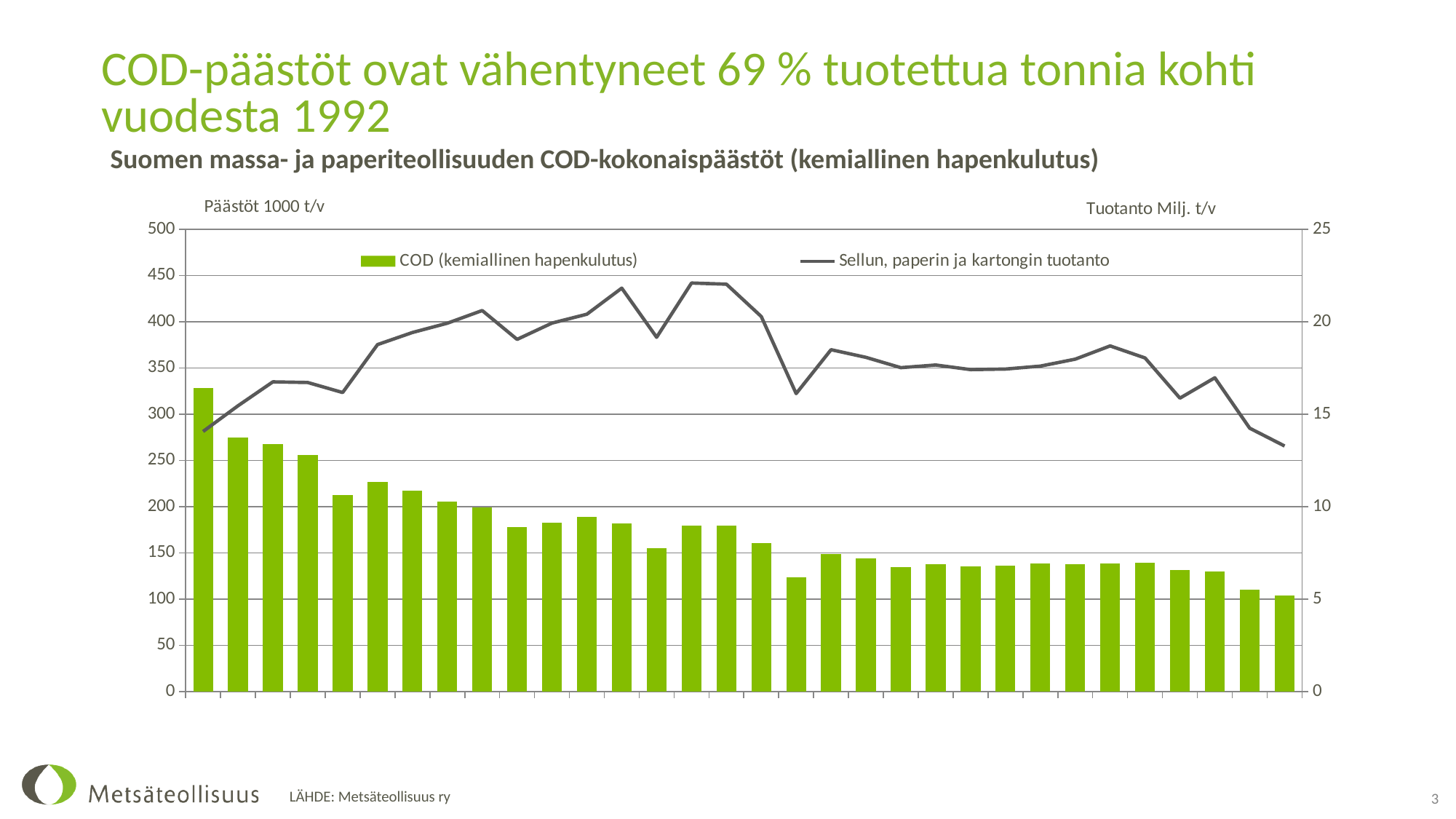
What kind of chart is shown on the slide? A combined bar and line chart Where is the lowest COD bar located in the chart? At the far right What is the maximum value shown on the right vertical axis? 25 Which series is drawn as green bars? COD (kemiallinen hapenkulutus) Which COD bar is the highest, the leftmost or the rightmost? The leftmost How many series does the legend list? 2 Is the value of the leftmost COD bar greater or less than 300? greater Is the last point of the Sellun, paperin ja kartongin tuotanto line greater or less than 15 on the right axis? less What is the title of the left vertical axis? Päästöt 1000 t/v Is the highest point of the Sellun, paperin ja kartongin tuotanto line greater or less than 20 on the right axis? greater Do the COD bars generally rise or fall from left to right? Fall